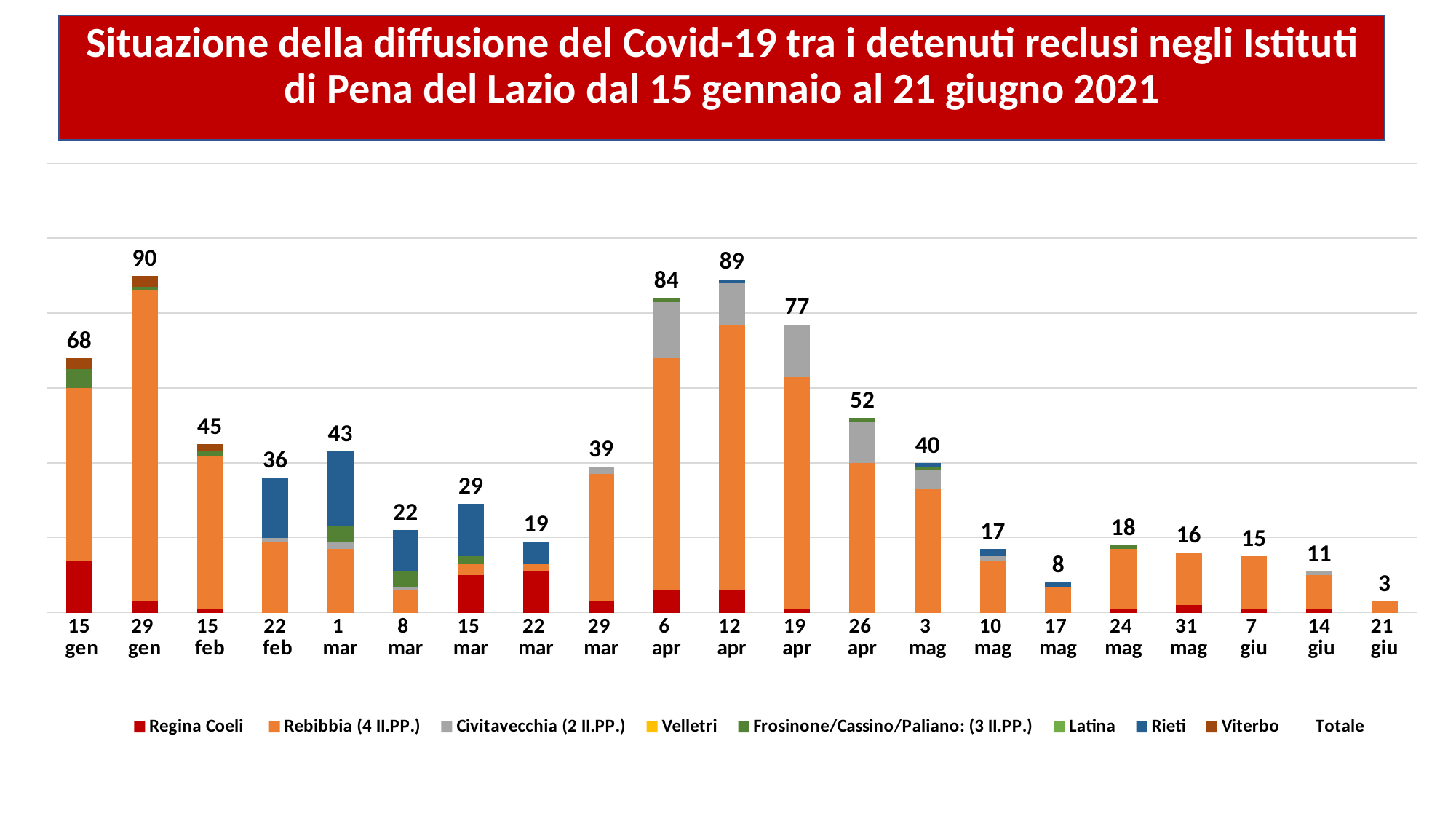
What is the difference between the totals for 12 apr and 6 apr? 5 Which date has the highest total? 29 gen What is the difference between the totals for 29 gen and 15 gen? 22 What is the total value shown for 12 apr? 89 Do the totals rise or fall from 26 apr to 21 giu? Fall Which date has the lowest total? 21 giu Which has a larger total, 19 apr or 26 apr? 19 apr What is the total value shown for 29 gen? 90 How many entries does the legend list? 9 What is the total value shown for 17 mag? 8 How many dates are shown on the x axis? 21 What kind of chart is shown on the slide? Stacked bar chart